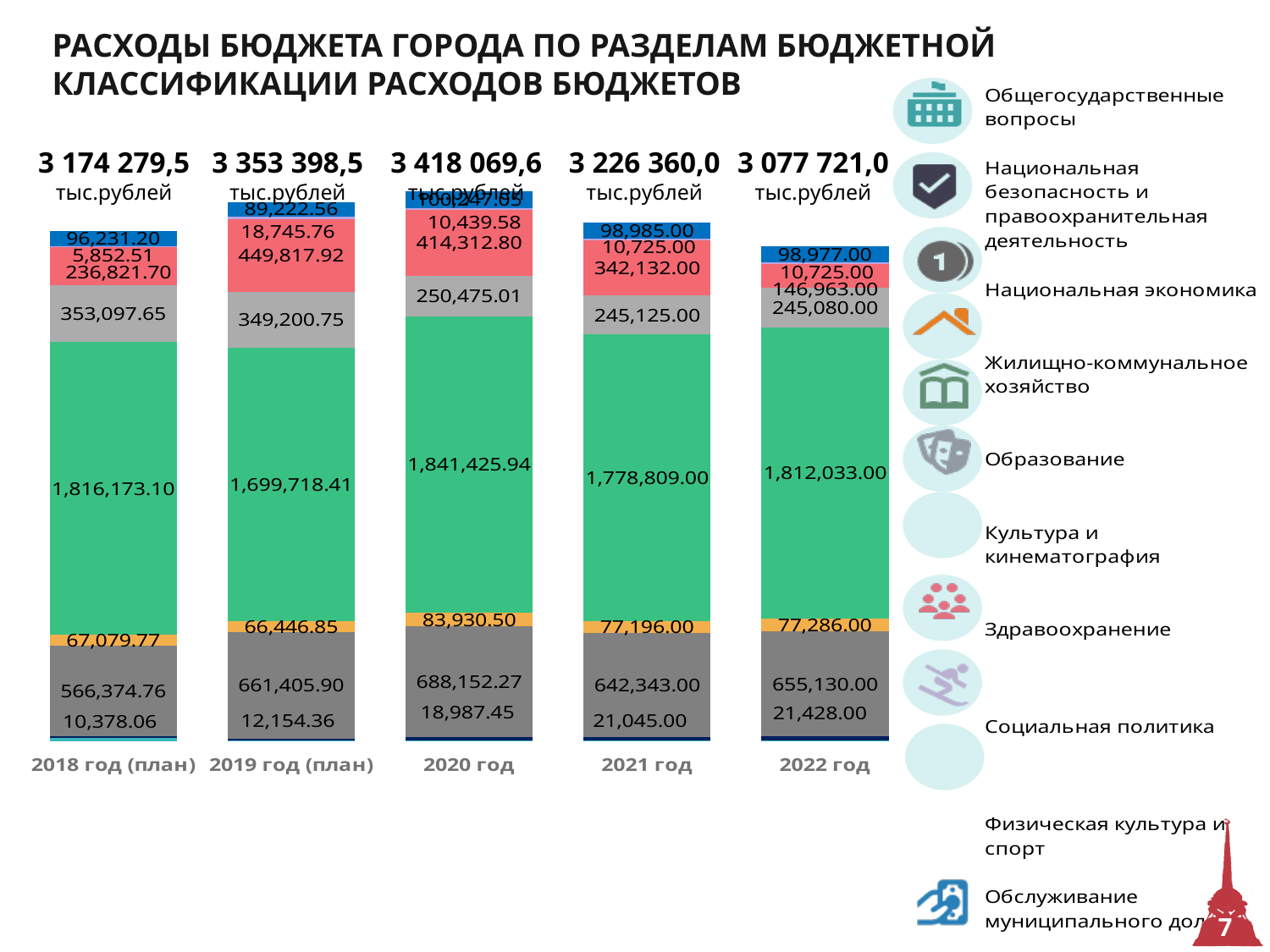
What is the value of the largest (green) segment in the bar for 2021 год? 1,778,809.00 Which year has the highest total printed above its bar? 2020 год What is the value of the largest (green) segment in the bar for 2019 год (план)? 1,699,718.41 What is the total printed above the bar for 2018 год (план)? 3 174 279,5 тыс.рублей How many bars (years) are plotted in the chart? 5 What is the total printed above the bar for 2020 год? 3 418 069,6 тыс.рублей What is the difference between the totals for 2020 год and 2021 год? 191 709,6 тыс.рублей Which is larger: the green segment for 2020 год (1,841,425.94) or for 2022 год (1,812,033.00)? 2020 год Do the totals above the bars rise or fall from 2020 год to 2022 год? fall In what units are the totals above the bars expressed? тыс.рублей Which year has the lowest total printed above its bar? 2022 год What kind of chart is shown on the slide? stacked bar chart